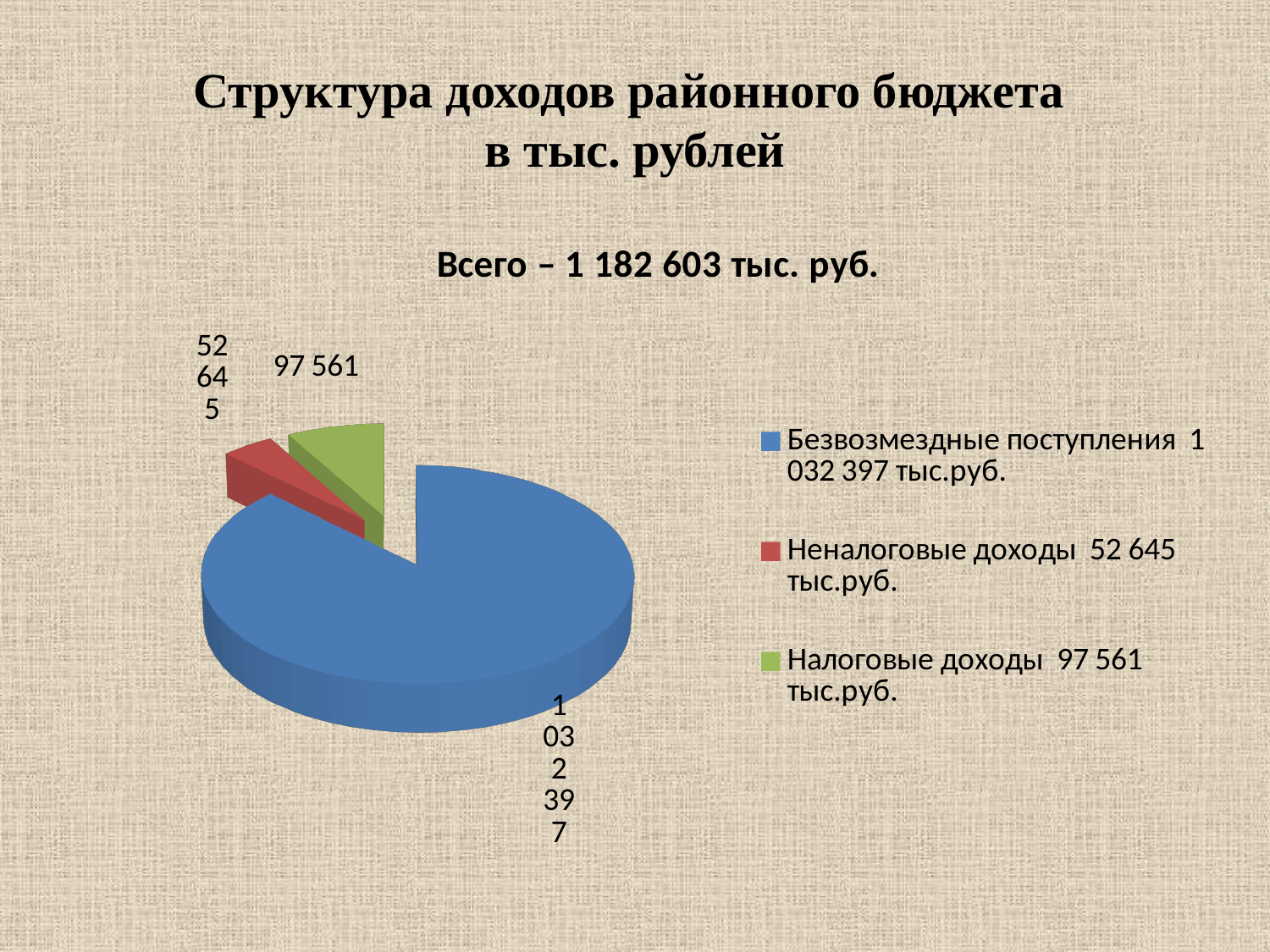
Which category has the smallest slice of the pie? Неналоговые доходы How many categories does the pie chart show? 3 What is the value for Безвозмездные поступления? 1 032 397 тыс.руб. What is the total of all the slices, as stated on the slide? 1 182 603 тыс. руб. Which is larger, Налоговые доходы or Неналоговые доходы? Налоговые доходы Which colour represents Неналоговые доходы in the pie chart? Red What kind of chart is shown on the slide? Pie chart What is the difference between Безвозмездные поступления and Налоговые доходы? 934 836 тыс.руб. What is the difference between Налоговые доходы and Неналоговые доходы? 44 916 тыс.руб. Which category has the largest slice of the pie? Безвозмездные поступления What is the value for Неналоговые доходы? 52 645 тыс.руб. What is the value for Налоговые доходы? 97 561 тыс.руб.